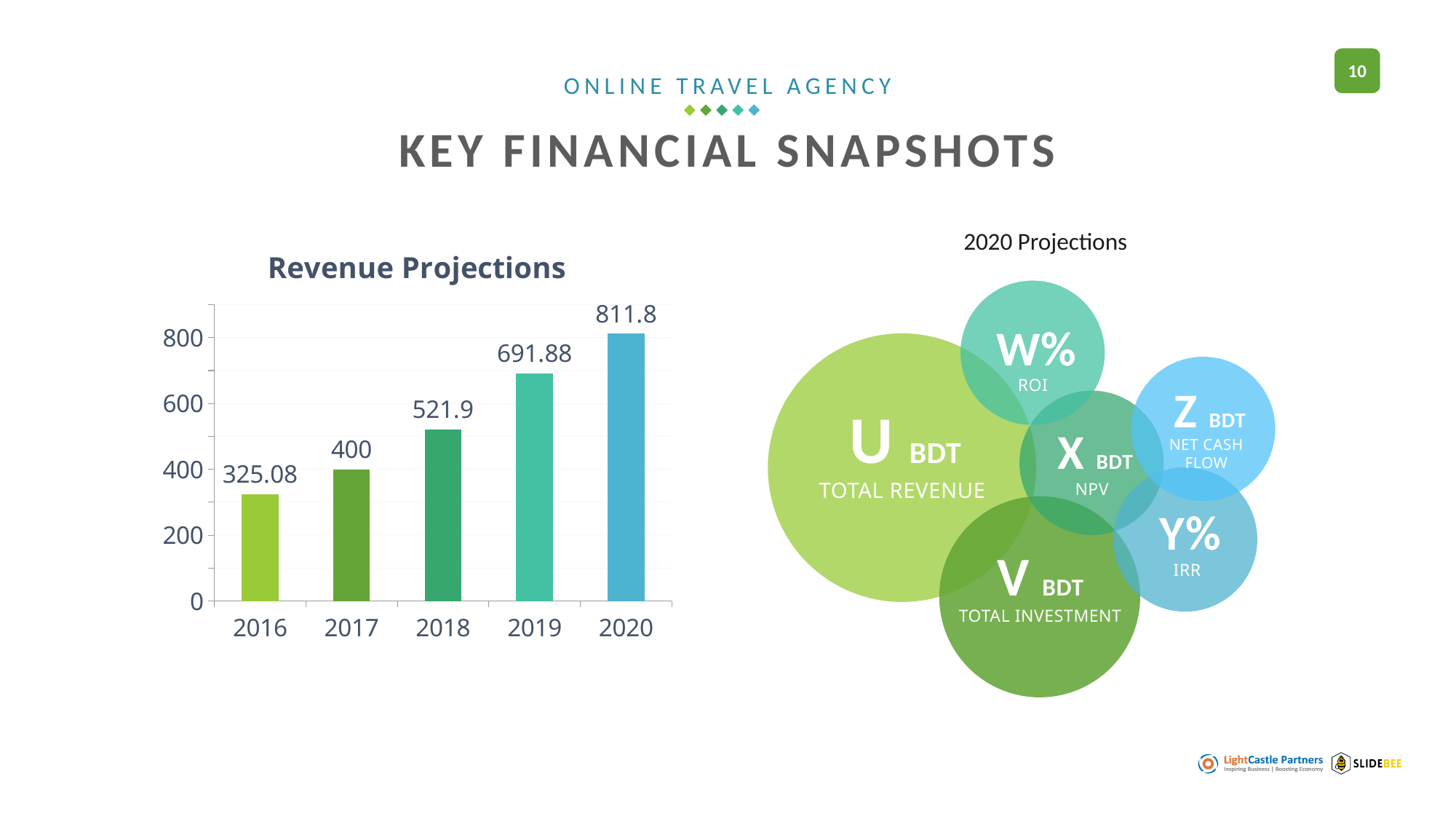
Which is larger, the revenue projection for 2018 or for 2017? 2018 Which year has the lowest revenue projection? 2016 What is the revenue projection for 2018? 521.9 What is the revenue projection for 2020? 811.8 Do the revenue projections rise or fall from 2016 to 2020? rise What kind of chart is the Revenue Projections chart? bar chart What is the title of the bar chart on the slide? Revenue Projections What is the difference between the revenue projections for 2019 and 2017? 291.88 What is the revenue projection for 2016? 325.08 Is the revenue projection for 2019 greater or less than 600? greater How many years are shown in the Revenue Projections chart? 5 Which year has the highest revenue projection? 2020